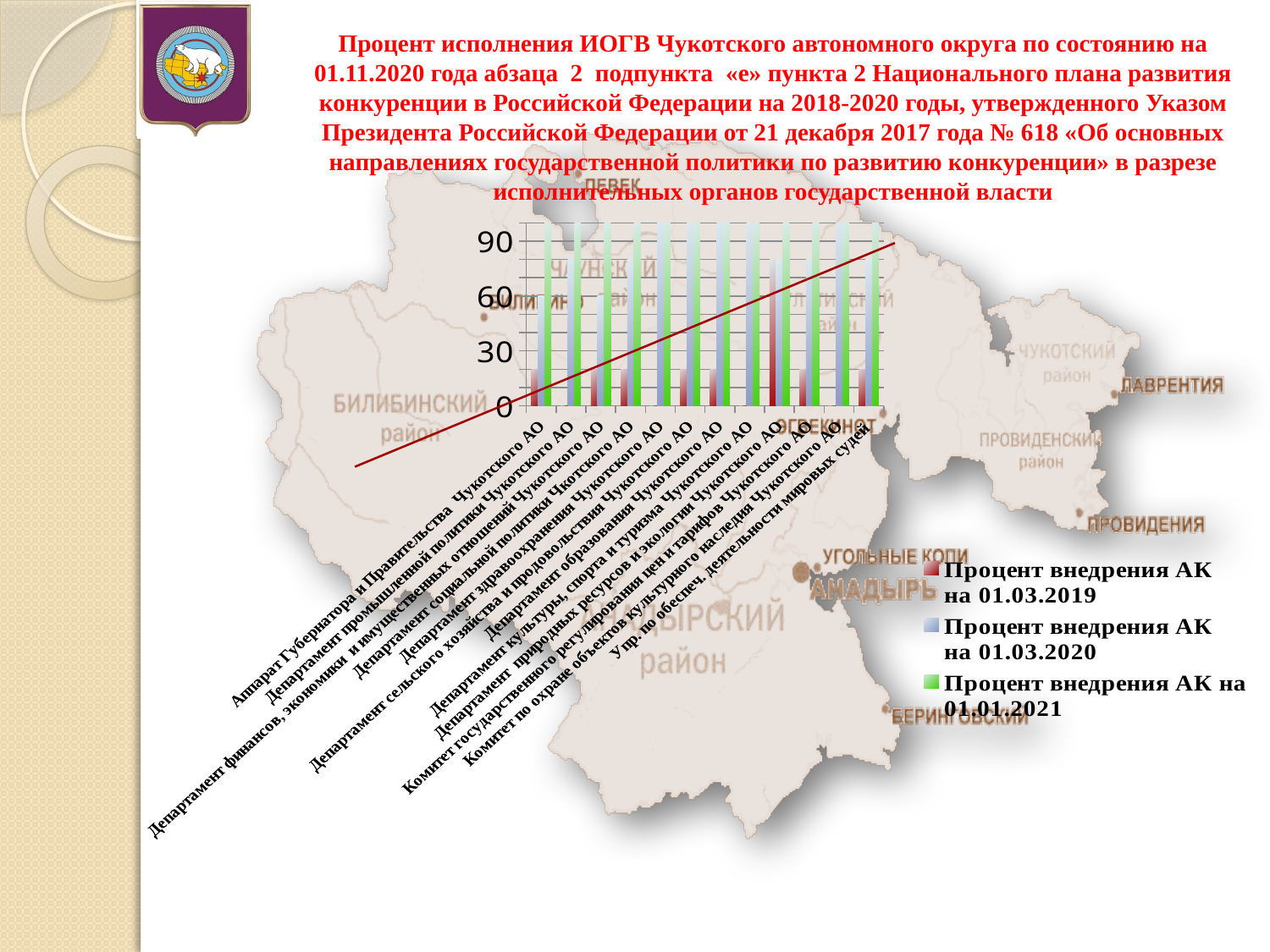
What is the first series listed in the chart legend? Процент внедрения АК на 01.03.2019 Is the value for Аппарат Губернатора и Правительства Чукотского АО in the series 'Процент внедрения АК на 01.03.2019' greater or less than 30? less What is the highest tick value shown on the vertical axis of the chart? 90 How many series does the chart legend list? 3 Is the value for Департамент здравоохранения Чукотского АО in the series 'Процент внедрения АК на 01.03.2019' greater or less than 30? less What is the last series listed in the chart legend? Процент внедрения АК на 01.01.2021 Is the value for Департамент образования Чукотского АО in the series 'Процент внедрения АК на 01.01.2021' greater or less than 60? greater What kind of chart is shown on the slide? bar chart How many categories (government bodies) are shown on the x axis of the chart? 12 For Департамент промышленной политики Чукотского АО, which is larger: the value for 01.03.2019 or the value for 01.01.2021? 01.01.2021 Across the three dates shown, do the values for each body generally rise or fall from 01.03.2019 to 01.01.2021? rise